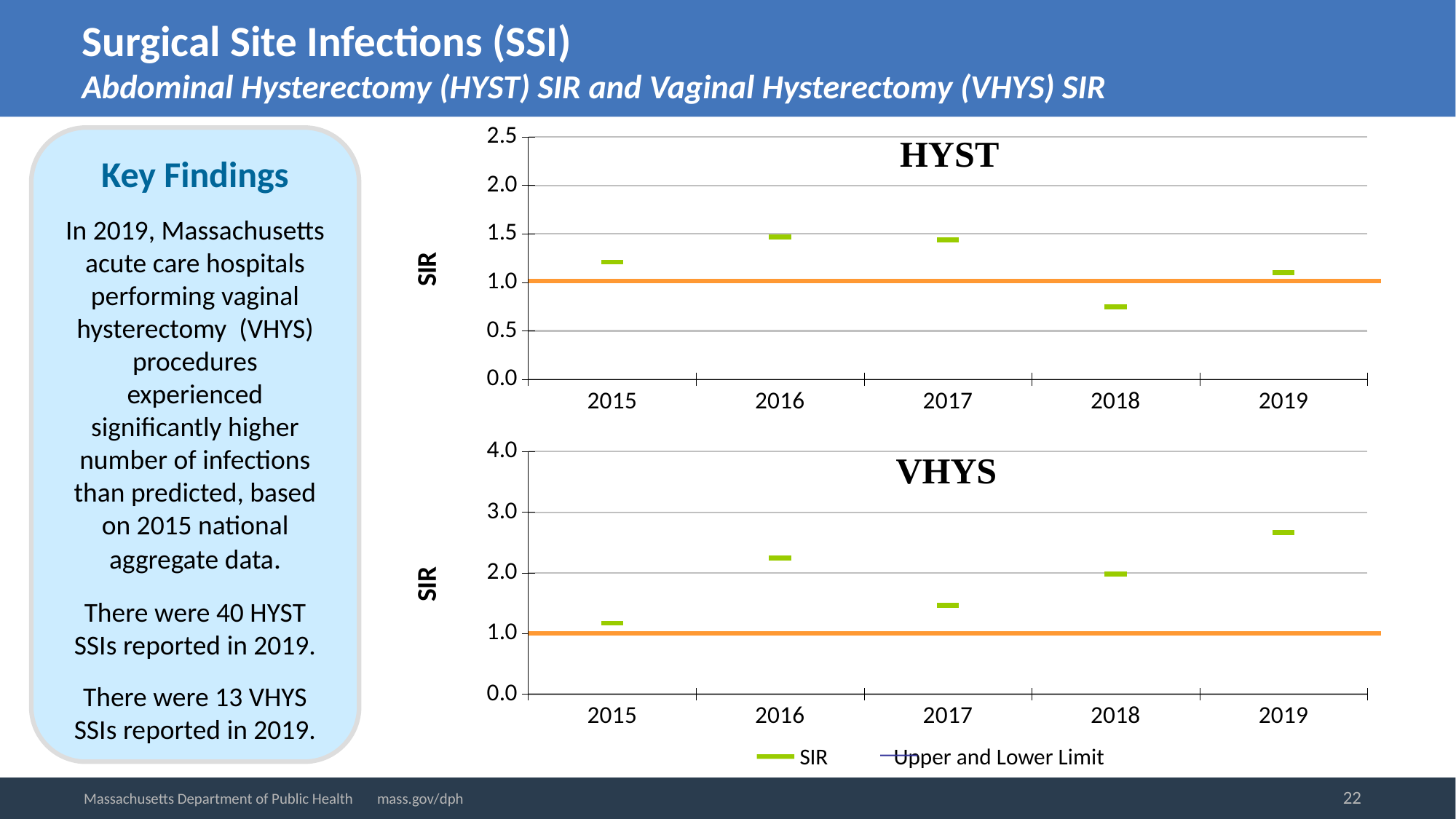
In the VHYS chart, is the SIR for 2019 greater or less than 2.0? greater In the HYST chart, which is larger, the SIR for 2015 or the SIR for 2018? 2015 In the VHYS chart, which year has the lowest SIR? 2015 How many series does the legend below the charts list? 2 In the HYST chart, which year has the lowest SIR? 2018 How many years are plotted on the x axis of the VHYS chart? 5 In the VHYS chart, which is larger, the SIR for 2016 or the SIR for 2017? 2016 In the HYST chart, is the SIR for 2016 greater or less than 1.0? greater In the HYST chart, is the SIR for 2018 greater or less than 1.0? less In the VHYS chart, does the SIR rise or fall from 2018 to 2019? rise In the VHYS chart, which year has the highest SIR? 2019